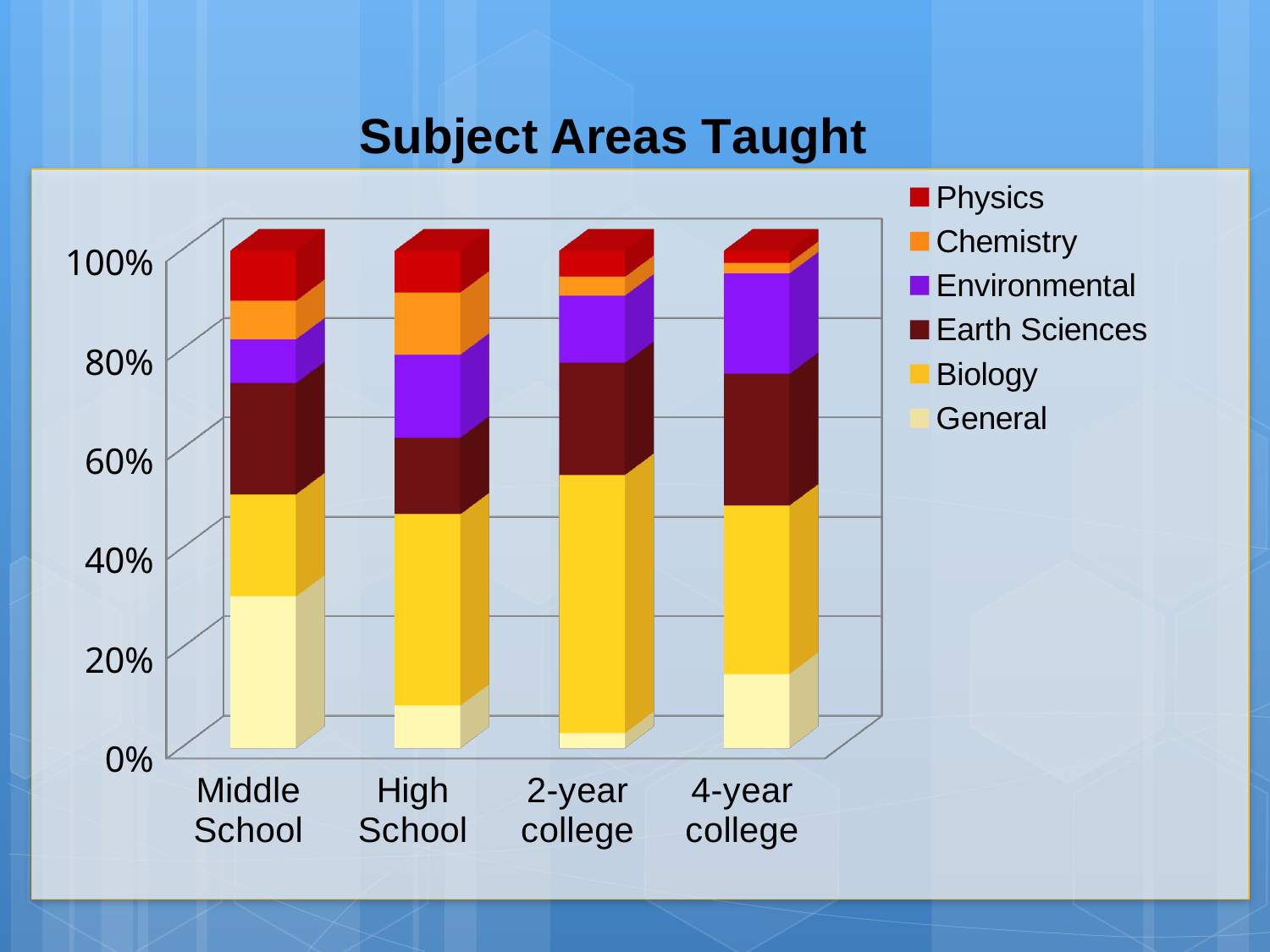
Is the General share for Middle School greater or less than 20%? greater What is the title of the chart? Subject Areas Taught Which category has the largest General share? Middle School What kind of chart is shown on the slide? Stacked bar chart Does the Physics share rise or fall from Middle School to 4-year college? fall How many categories are shown on the x axis? 4 How many series does the legend list? 6 Which category has the smallest General share? 2-year college Is the Biology share larger for 2-year college or for Middle School? 2-year college Which category has the largest Chemistry share? High School Which series is shown in yellow in the legend? Biology Which category has the smallest Physics share? 4-year college